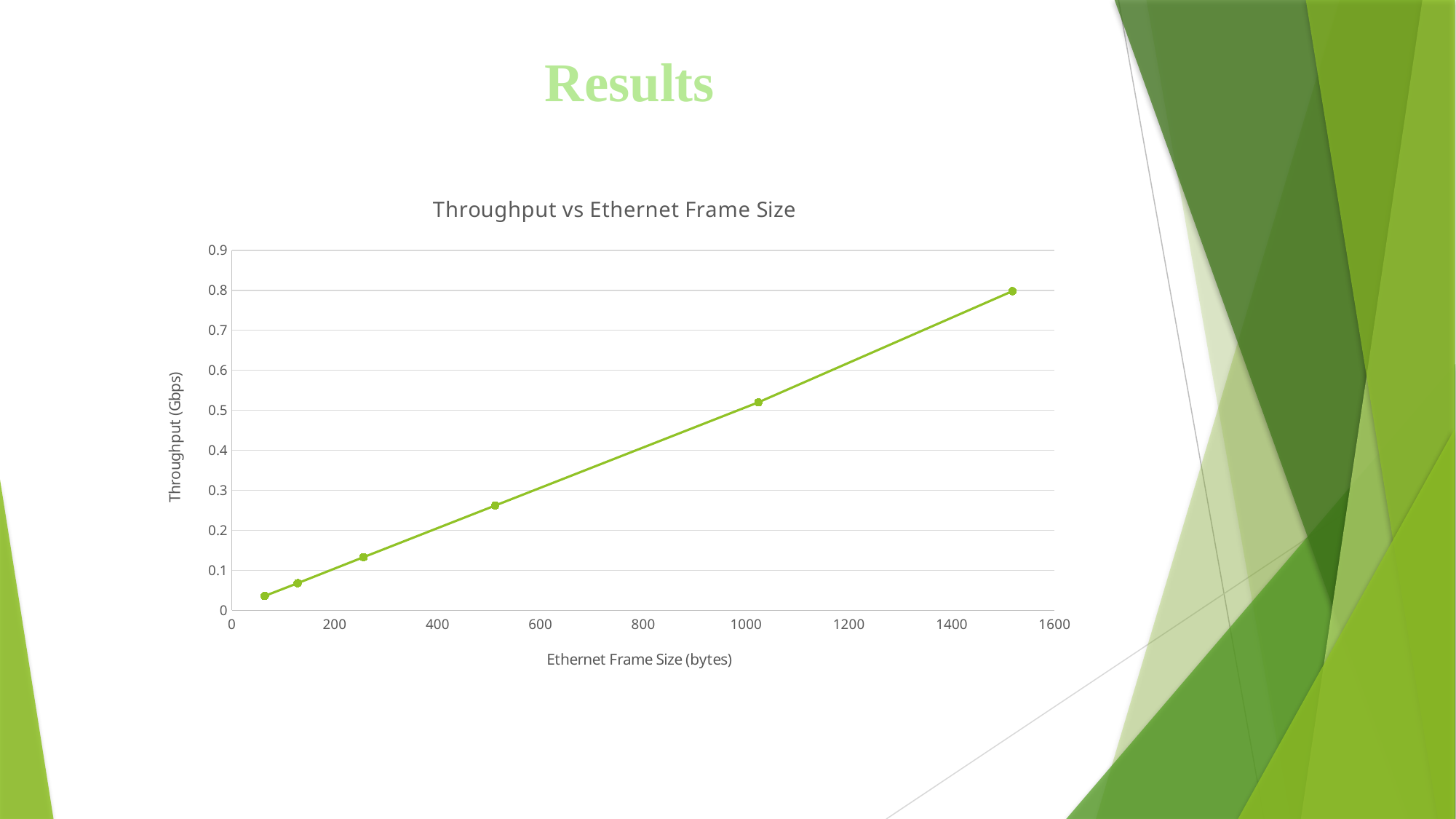
How many data points are plotted on the line? 6 What is the title of the chart? Throughput vs Ethernet Frame Size What kind of chart is shown on the slide? line chart Is the throughput value for the point near 1000 bytes greater or less than 0.4? greater Is the throughput value for the point near 500 bytes greater or less than 0.2? greater Which has the larger throughput: the point near 1000 bytes or the point near 500 bytes? the point near 1000 bytes Which plotted point has the highest throughput, the leftmost or the rightmost? rightmost Is the throughput value for the leftmost point greater or less than 0.1? less Does throughput rise or fall as Ethernet frame size increases? rise What is the label of the vertical axis? Throughput (Gbps)